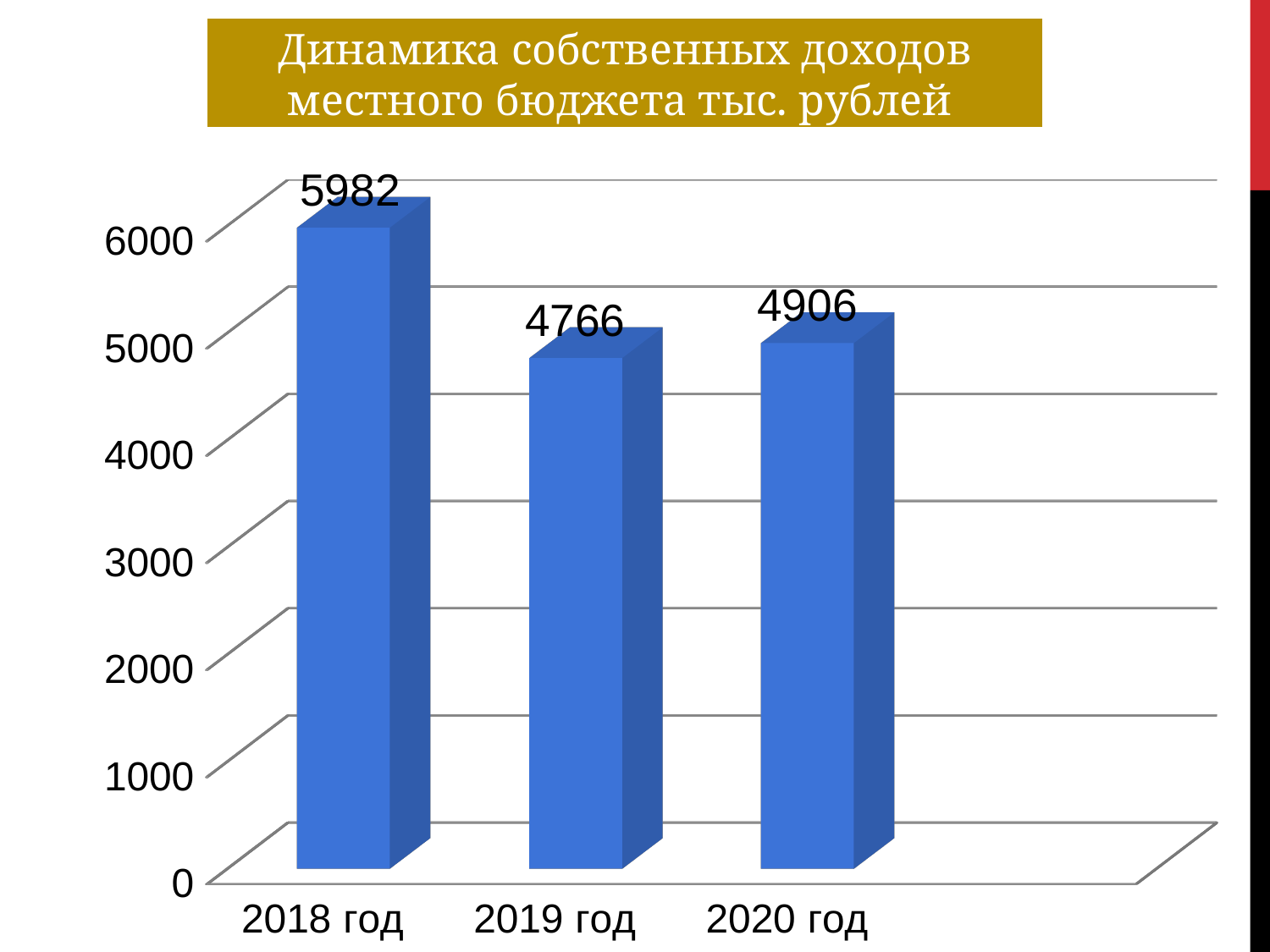
Which year has the lowest value? 2019 год Which year has the highest value? 2018 год What is the value for 2019 год? 4766 Which is larger, the value for 2018 год or the value for 2020 год? 2018 год What is the value for 2020 год? 4906 How many years are shown on the chart? 3 What is the title of the chart? Динамика собственных доходов местного бюджета тыс. рублей What is the difference between the values for 2020 год and 2019 год? 140 What kind of chart is shown on the slide? bar chart Is the value for 2019 год greater or less than 5000? less What is the value for 2018 год? 5982 What is the difference between the values for 2018 год and 2019 год? 1216